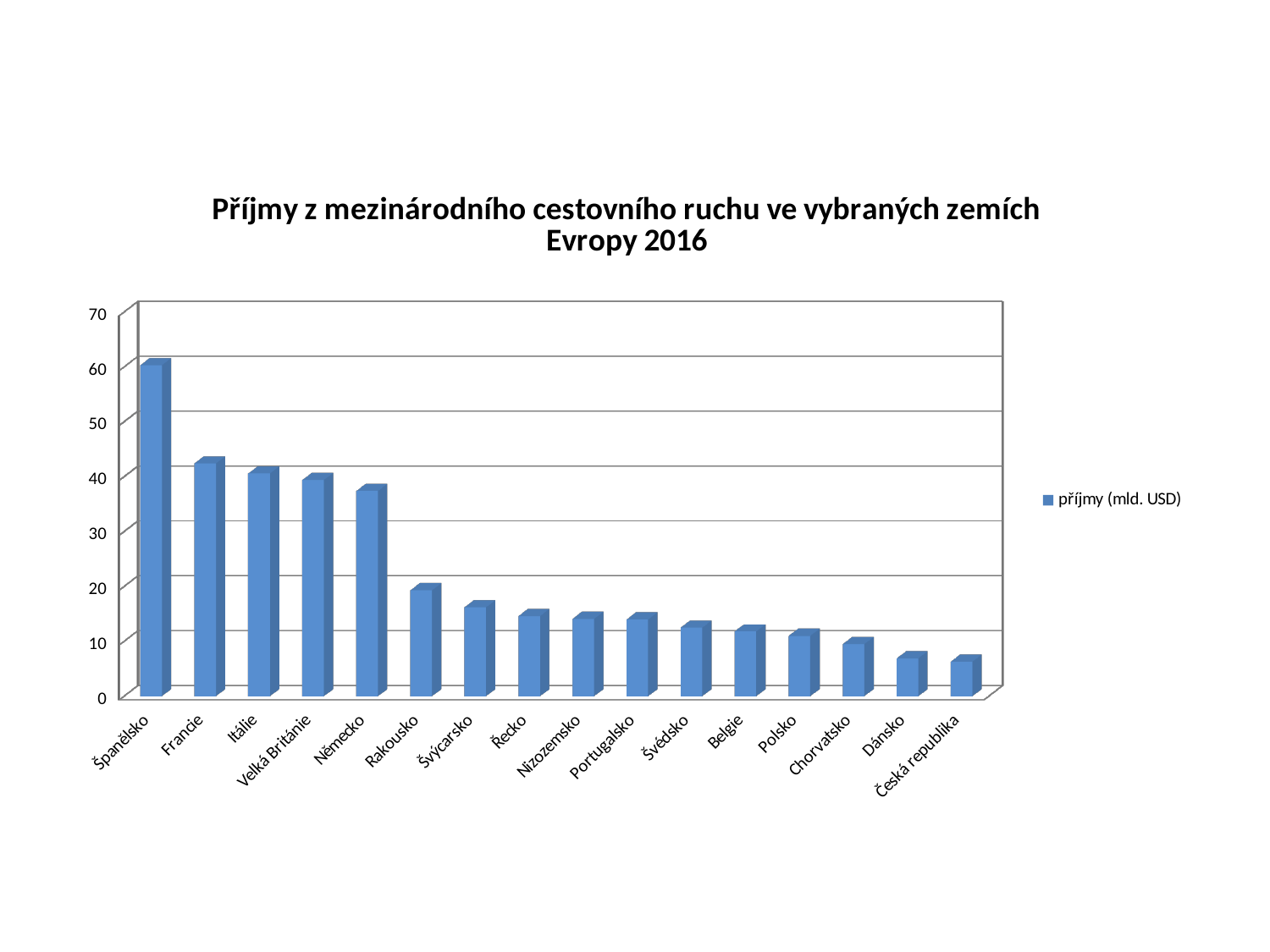
Which country has the lowest value in the chart? Česká republika Which has a larger value, Francie or Německo? Francie How many series does the legend list? 1 Is the value for Španělsko greater or less than 50? greater What kind of chart is shown on the slide? bar chart Is the value for Česká republika greater or less than 10? less How many countries are shown on the x axis? 16 Which country has the highest value in the chart? Španělsko Is the value for Německo greater or less than 40? less What is the legend entry of the series shown in the chart? příjmy (mld. USD) Do the values rise or fall from left to right along the x axis? fall